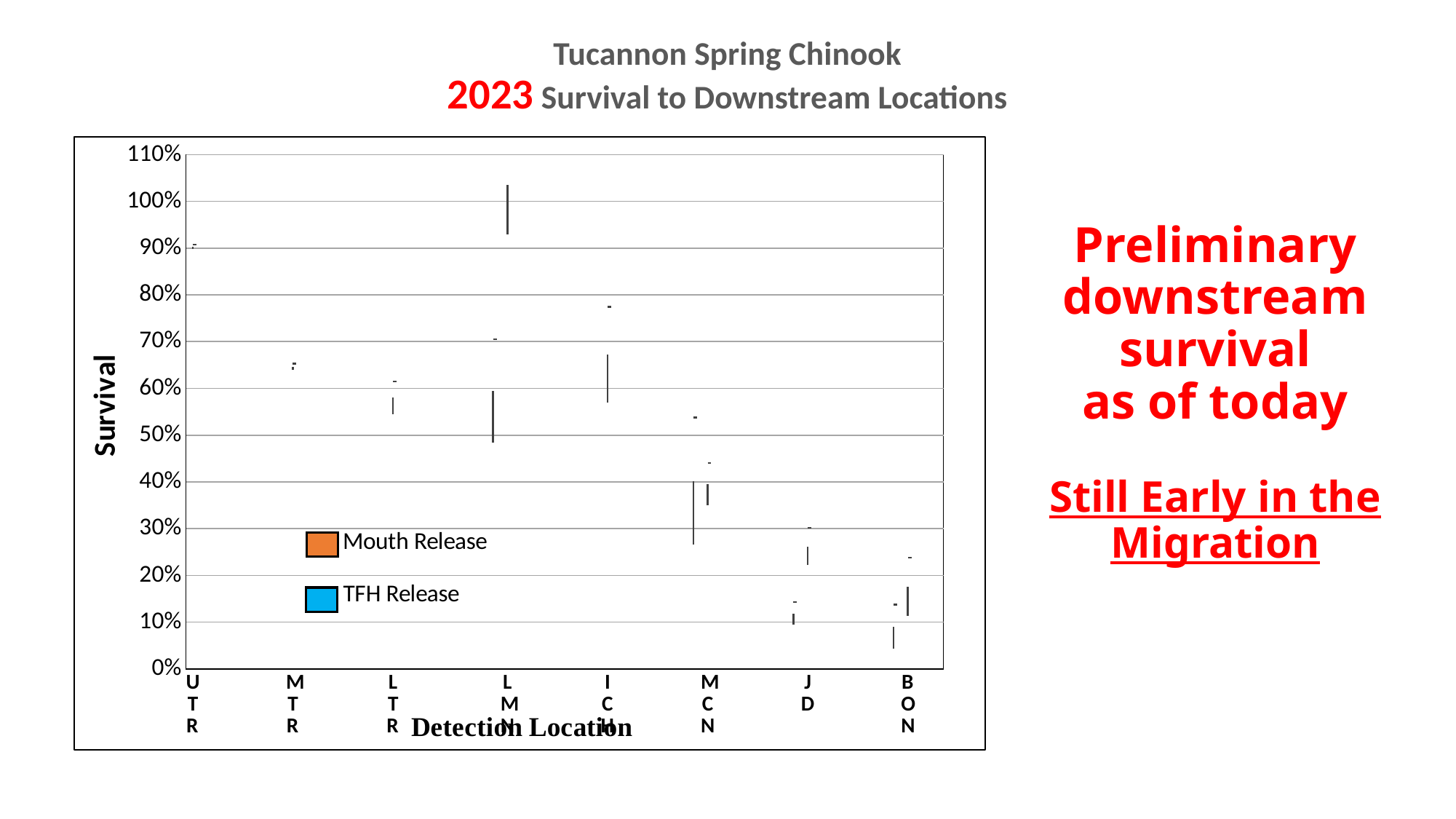
Which detection location has the lowest plotted survival value? BON Is the value plotted for UTR greater or less than 80%? greater How many series does the legend list? 2 How many detection locations are shown on the x axis? 8 Is the value plotted for MTR greater or less than 50%? greater What is the title of the y axis? Survival Are all the values plotted for JD greater or less than 40%? less Do the survival values generally rise or fall moving from UTR to BON along the x axis? fall What are the two series named in the legend? Mouth Release and TFH Release What kind of chart is shown on the slide? stock chart (high-low chart) Which detection location has the highest plotted survival value? LMN